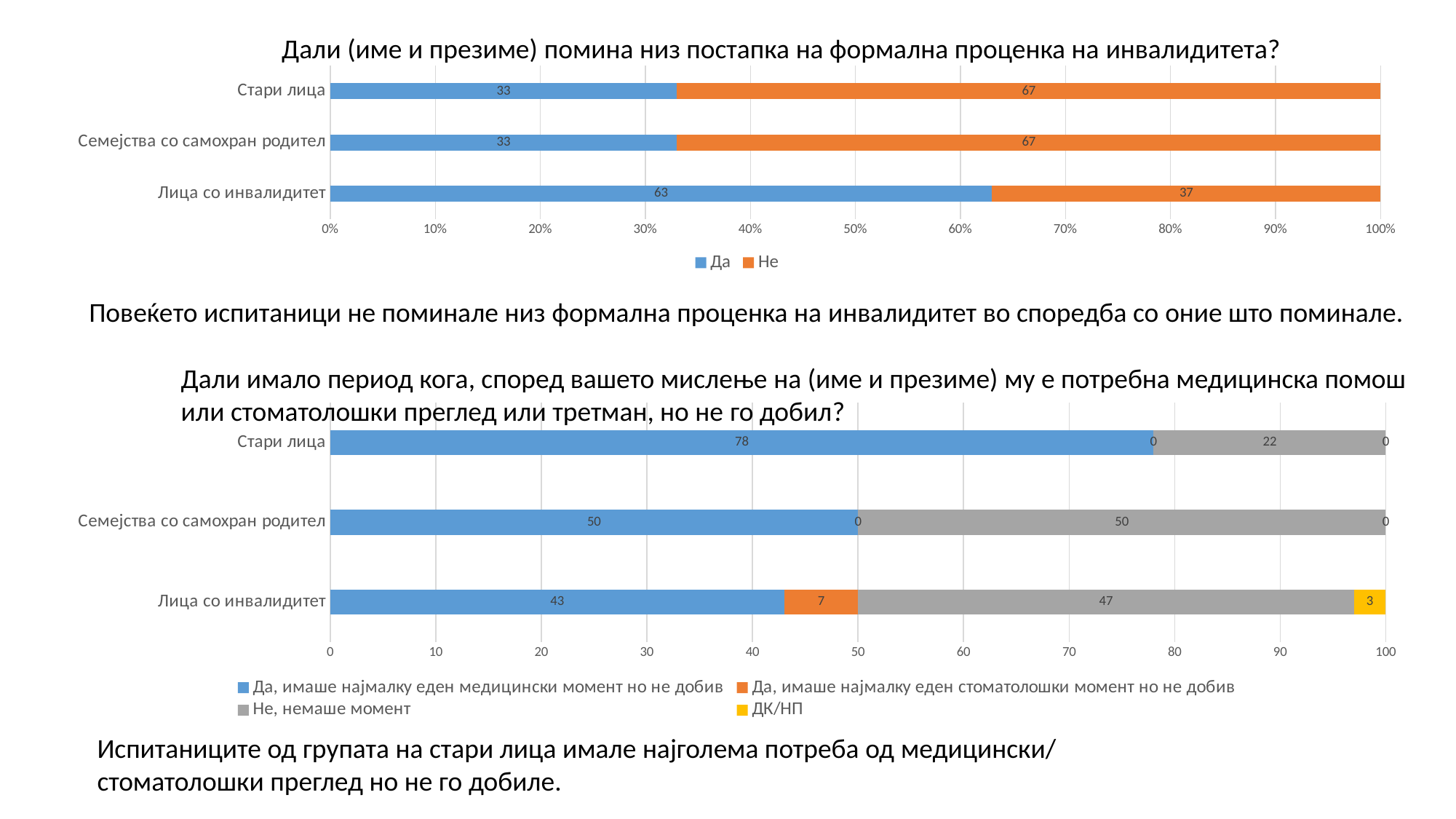
In the top chart, what is the value for "Не" for Стари лица? 67 In the bottom chart, what is the value for "Не, немаше момент" for Лица со инвалидитет? 47 In the bottom chart, what is the value for "ДК/НП" for Лица со инвалидитет? 3 In the bottom chart, how many series does the legend list? 4 In the bottom chart, is the value for "Не, немаше момент" for Стари лица larger or smaller than that for Семејства со самохран родител? Smaller In the top chart, how many series does the legend list? 2 What type of chart is the top chart? Stacked bar chart In the top chart, what is the value for "Да" for Лица со инвалидитет? 63 In the bottom chart, which category has the lowest value for "Да, имаше најмалку еден медицински момент но не добив"? Лица со инвалидитет In the bottom chart, what is the value for "Да, имаше најмалку еден медицински момент но не добив" for Стари лица? 78 In the top chart, which category has the highest value for "Да"? Лица со инвалидитет In the top chart, what is the difference between the "Не" and "Да" values for Семејства со самохран родител? 34